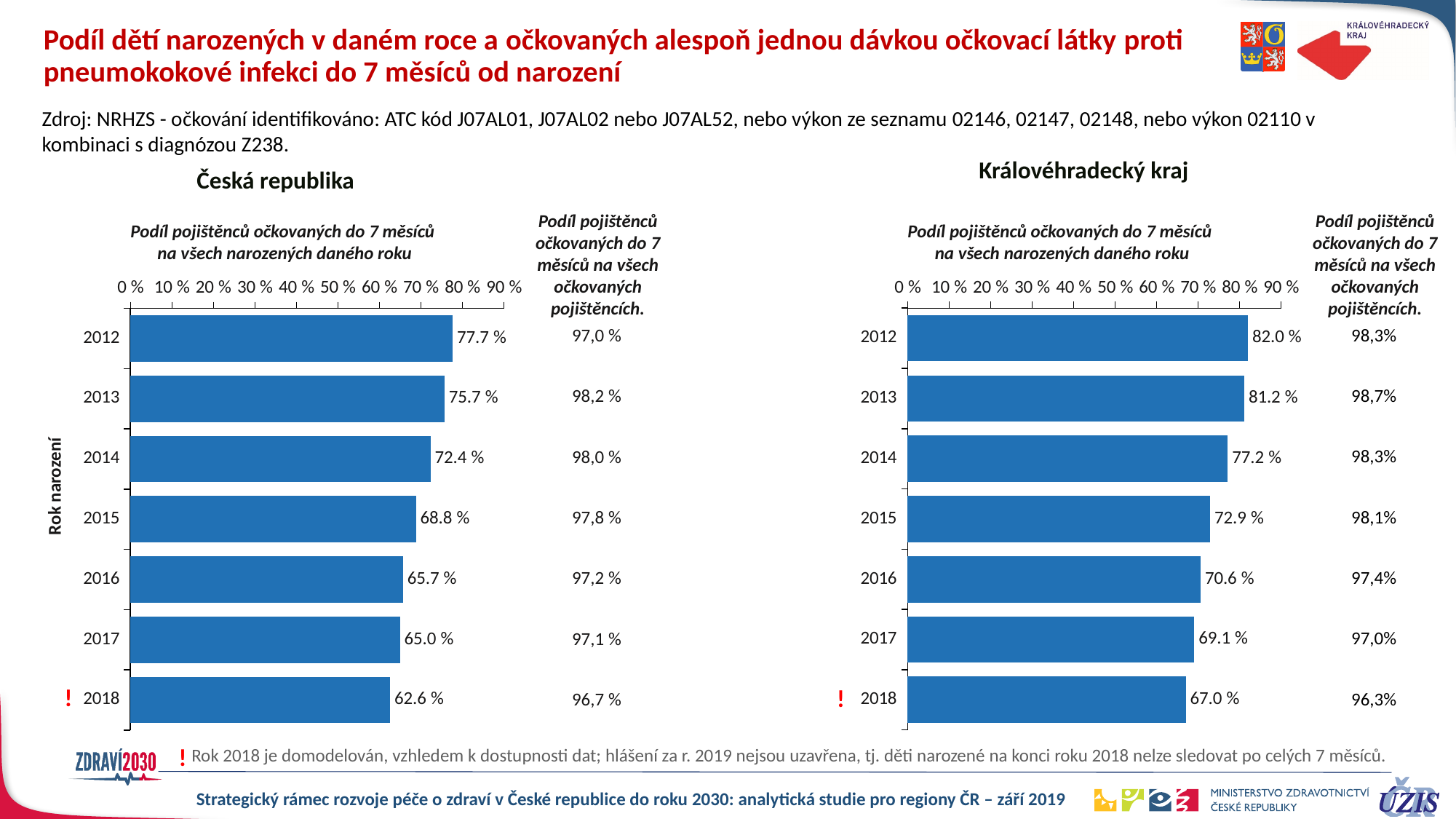
How many years are shown in the Královéhradecký kraj chart? 7 In the Královéhradecký kraj chart, what is the value for 2018? 67.0 % In the Královéhradecký kraj chart, what is the difference between the values for 2013 and 2014? 4.0 % In the Česká republika chart, which year has the lowest value? 2018 In the Česká republika chart, is the value for 2014 greater or less than 70 %? greater In the Královéhradecký kraj chart, do the values rise or fall from 2012 to 2018? fall Which is larger: the value for 2016 in the Česká republika chart or the value for 2016 in the Královéhradecký kraj chart? Královéhradecký kraj In the Česká republika chart, what is the value for 2012? 77.7 % In the Královéhradecký kraj chart, what is the value for 2015? 72.9 % In the Česká republika chart, what is the difference between the values for 2012 and 2018? 15.1 % In the Královéhradecký kraj chart, which year has the highest value? 2012 What kind of chart is the Česká republika chart? bar chart